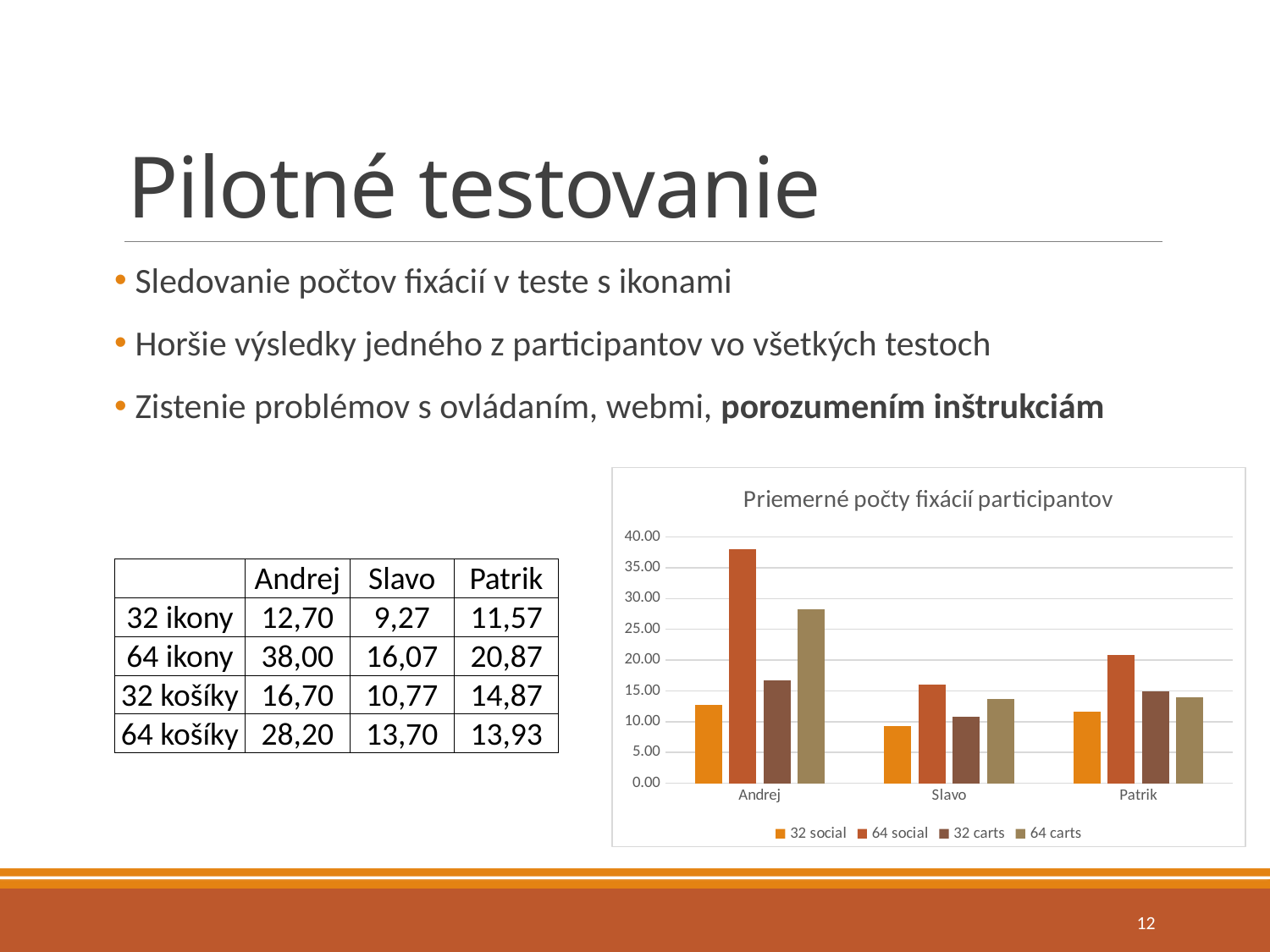
How many participants (categories) are shown on the x axis of the chart? 3 How many series does the legend of the chart list? 4 Which participant has the highest bar for the 64 social series? Andrej Is the 64 carts value for Andrej greater or less than 25.00? greater Is the 64 social value for Andrej greater or less than 35.00? greater What is the title of the chart? Priemerné počty fixácií participantov Which is larger: the 64 social value for Patrik or the 64 social value for Slavo? Patrik Is the 64 carts value for Slavo greater or less than 15.00? less For Andrej, which is larger: the 32 carts value or the 64 carts value? 64 carts What kind of chart is shown on the slide? bar chart Which participant has the lowest bar for the 32 social series? Slavo